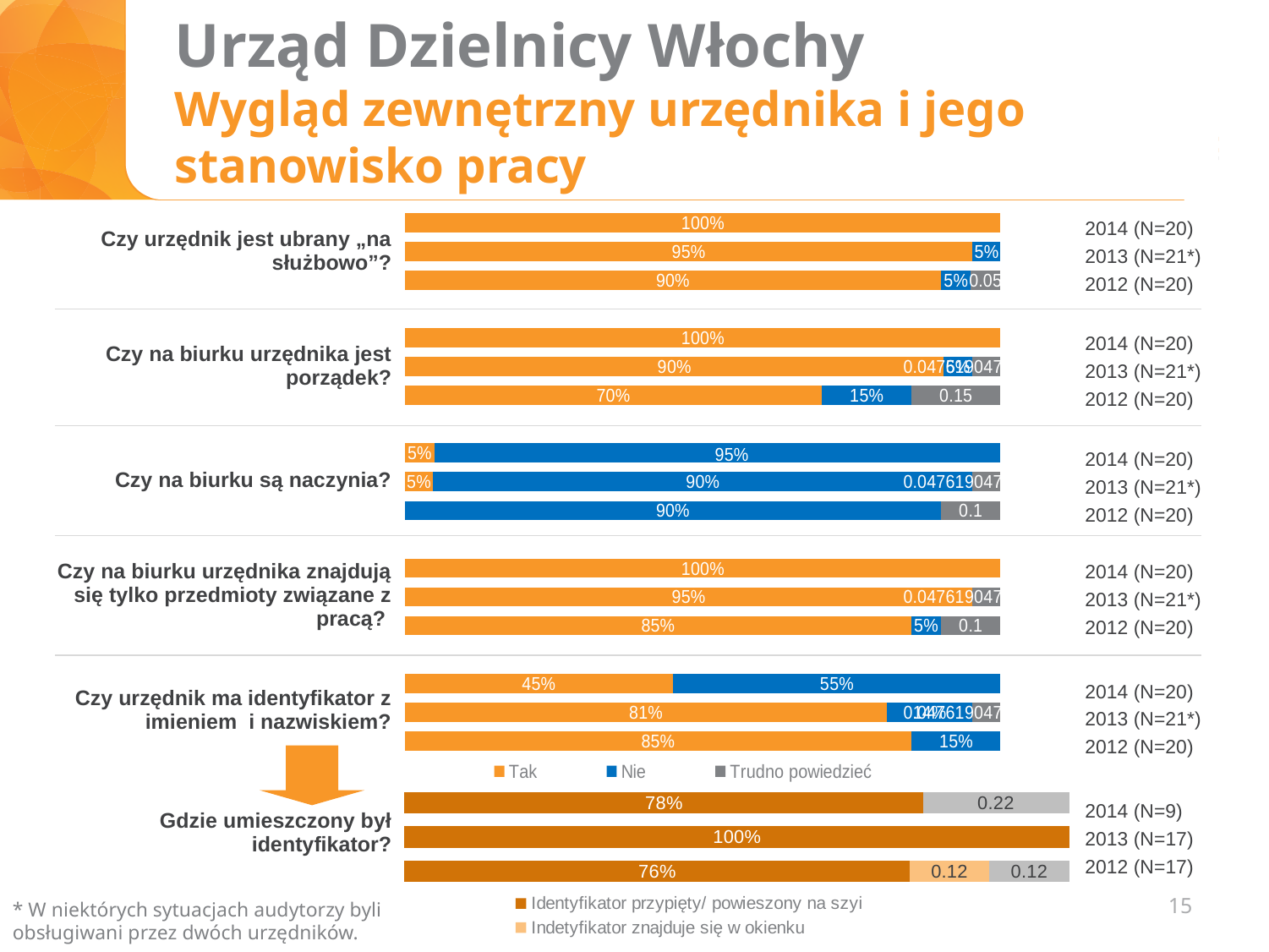
In the chart "Gdzie umieszczony był identyfikator?", what share of identifiers were pinned/hung on the neck in 2014 (N=9)? 78% How many series does the legend with "Tak", "Nie" and "Trudno powiedzieć" list? 3 In the chart "Czy urzędnik jest ubrany „na służbowo”?", what share answered "Tak" in 2014 (N=20)? 100% In the chart "Czy urzędnik jest ubrany „na służbowo”?", what share answered "Nie" in 2013 (N=21*)? 5% In the chart "Gdzie umieszczony był identyfikator?", which year has the highest share for "Identyfikator przypięty/ powieszony na szyi"? 2013 (N=17) In the chart "Czy na biurku urzędnika jest porządek?", what share answered "Nie" in 2012 (N=20)? 15% In the chart "Czy urzędnik ma identyfikator z imieniem i nazwiskiem?", what is the difference between the "Tak" share in 2012 (N=20) and in 2014 (N=20)? 40% In the chart "Czy na biurku urzędnika jest porządek?", what share answered "Tak" in 2012 (N=20)? 70% In the chart "Czy na biurku urzędnika znajdują się tylko przedmioty związane z pracą?", what share answered "Tak" in 2012 (N=20)? 85% In the chart "Czy na biurku są naczynia?", what share answered "Nie" in 2014 (N=20)? 95% In the chart "Czy urzędnik ma identyfikator z imieniem i nazwiskiem?", which year has the lowest share of "Tak" answers? 2014 (N=20) In the chart "Czy urzędnik ma identyfikator z imieniem i nazwiskiem?", what share answered "Nie" in 2014 (N=20)? 55%